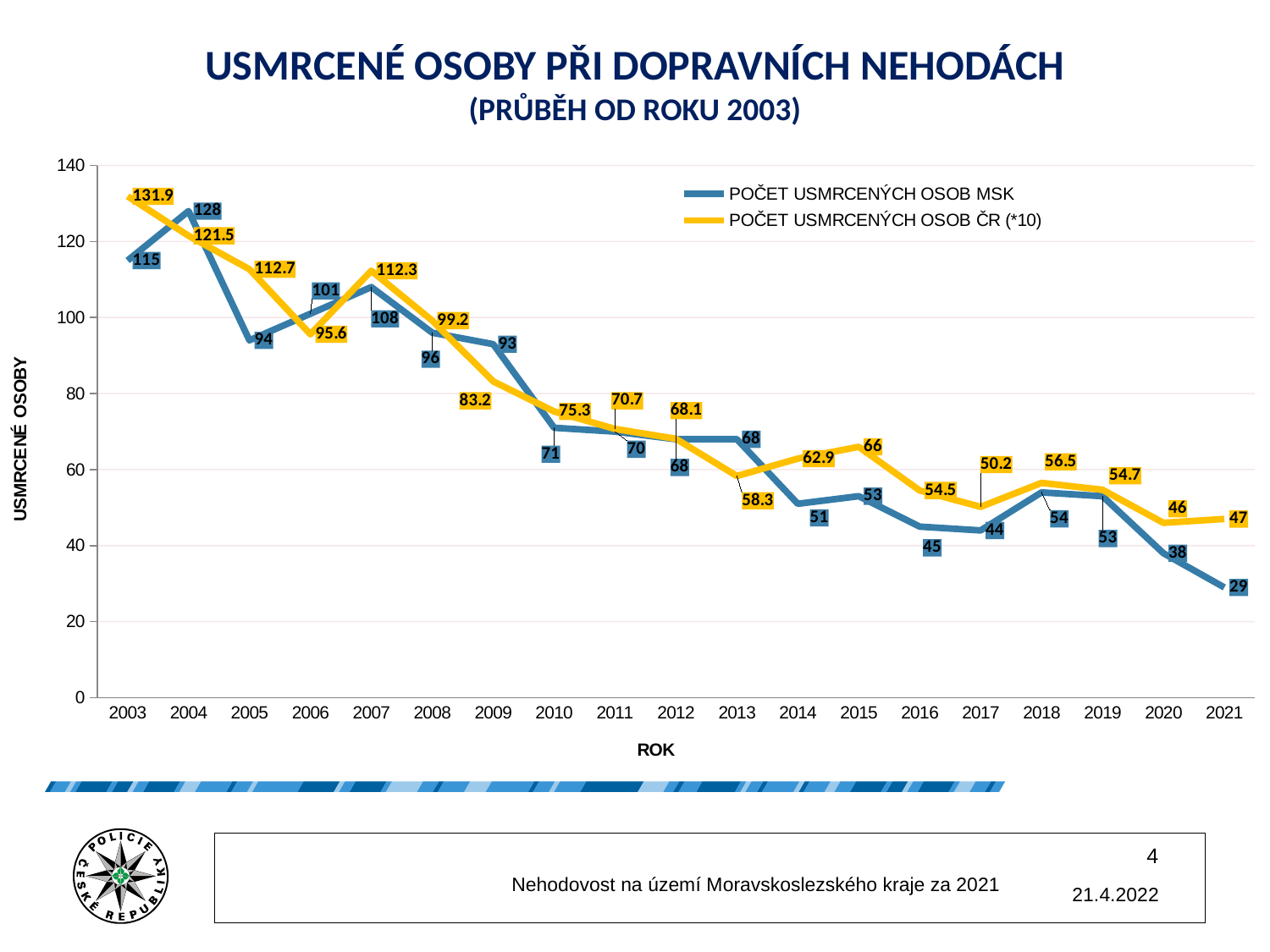
How many series does the legend list? 2 Overall, do the POČET USMRCENÝCH OSOB MSK values rise or fall from 2003 to 2021? fall What type of chart is shown on the slide? line chart What is the value for POČET USMRCENÝCH OSOB MSK in 2004? 128 What is the value for POČET USMRCENÝCH OSOB ČR (*10) in 2009? 83.2 What is the label of the y axis? USMRCENÉ OSOBY In which year is the POČET USMRCENÝCH OSOB MSK series highest? 2004 What is the value for POČET USMRCENÝCH OSOB MSK in 2021? 29 How many years are plotted along the x axis? 19 What is the difference between the POČET USMRCENÝCH OSOB MSK values for 2003 and 2021? 86 Which series has the larger value in 2006, POČET USMRCENÝCH OSOB MSK or POČET USMRCENÝCH OSOB ČR (*10)? POČET USMRCENÝCH OSOB MSK In which year is the POČET USMRCENÝCH OSOB ČR (*10) series lowest? 2020